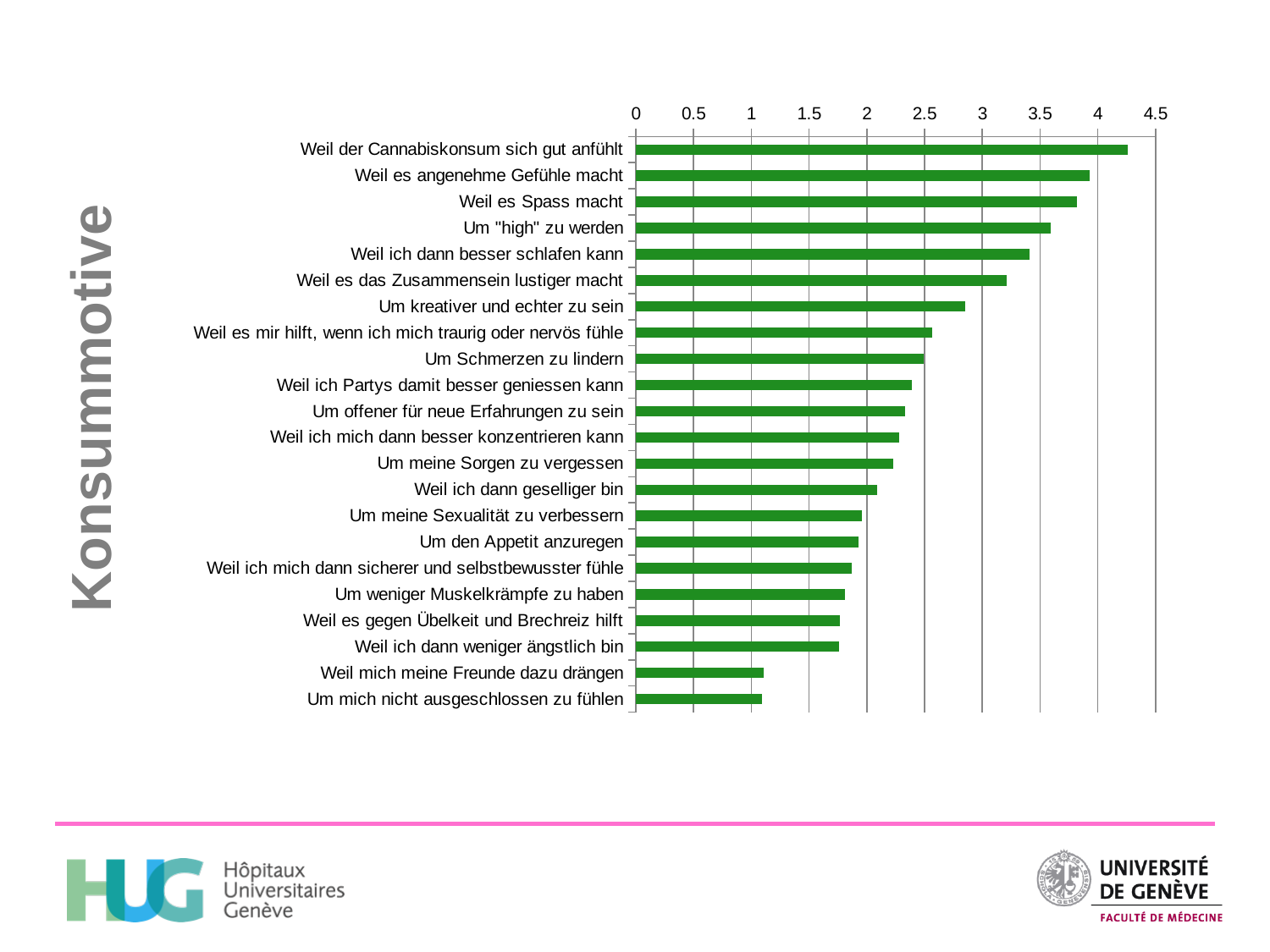
Is the value for "Weil es Spass macht" greater or less than 3.5? greater Is the value for "Weil der Cannabiskonsum sich gut anfühlt" greater or less than 4? greater Which has the larger value: "Weil es Spass macht" or "Weil ich dann besser schlafen kann"? Weil es Spass macht Is the value for "Um den Appetit anzuregen" greater or less than 2? less Which category has the highest value in the chart? Weil der Cannabiskonsum sich gut anfühlt How many categories (motives) are plotted in the chart? 22 What kind of chart is shown on the slide? bar chart Which has the larger value: "Um "high" zu werden" or "Um Schmerzen zu lindern"? Um "high" zu werden Do the bar values rise or fall going from the top category to the bottom category? fall What is the title shown on the slide for this chart? Konsummotive